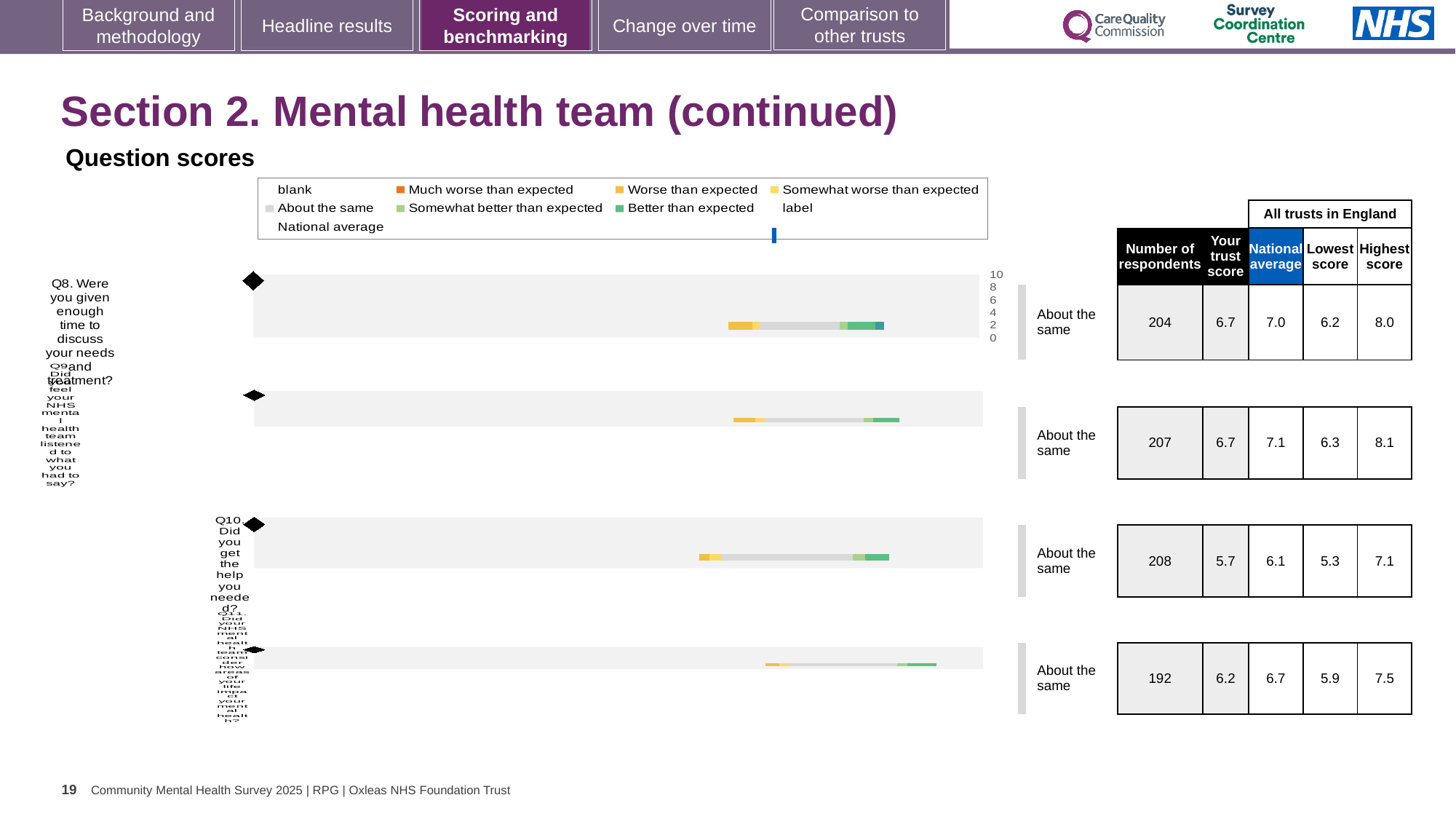
Which question (Q8 to Q11) has the lowest 'Your trust score' in the tables? Q10 For Q11, what is the difference between the Highest score and the Lowest score in the table? 1.6 In the table beside the Q9 chart, what is the Highest score among all trusts in England? 8.1 How many question charts (Q8 to Q11) are shown on the slide? 4 What benchmark label is shown next to the Q8 chart? About the same In the legend above the charts, what colour represents 'Much worse than expected'? orange In the table beside the Q11 chart, how many respondents are listed? 192 In the legend above the charts, what colour represents 'Better than expected'? green In the table beside the Q10 chart, what is the National average score? 6.1 What kind of chart is used to show the question scores for Q8 to Q11? bar chart In the table beside the Q8 chart, what is the 'Your trust score' value? 6.7 For Q10, which is larger: the trust score or the National average? National average